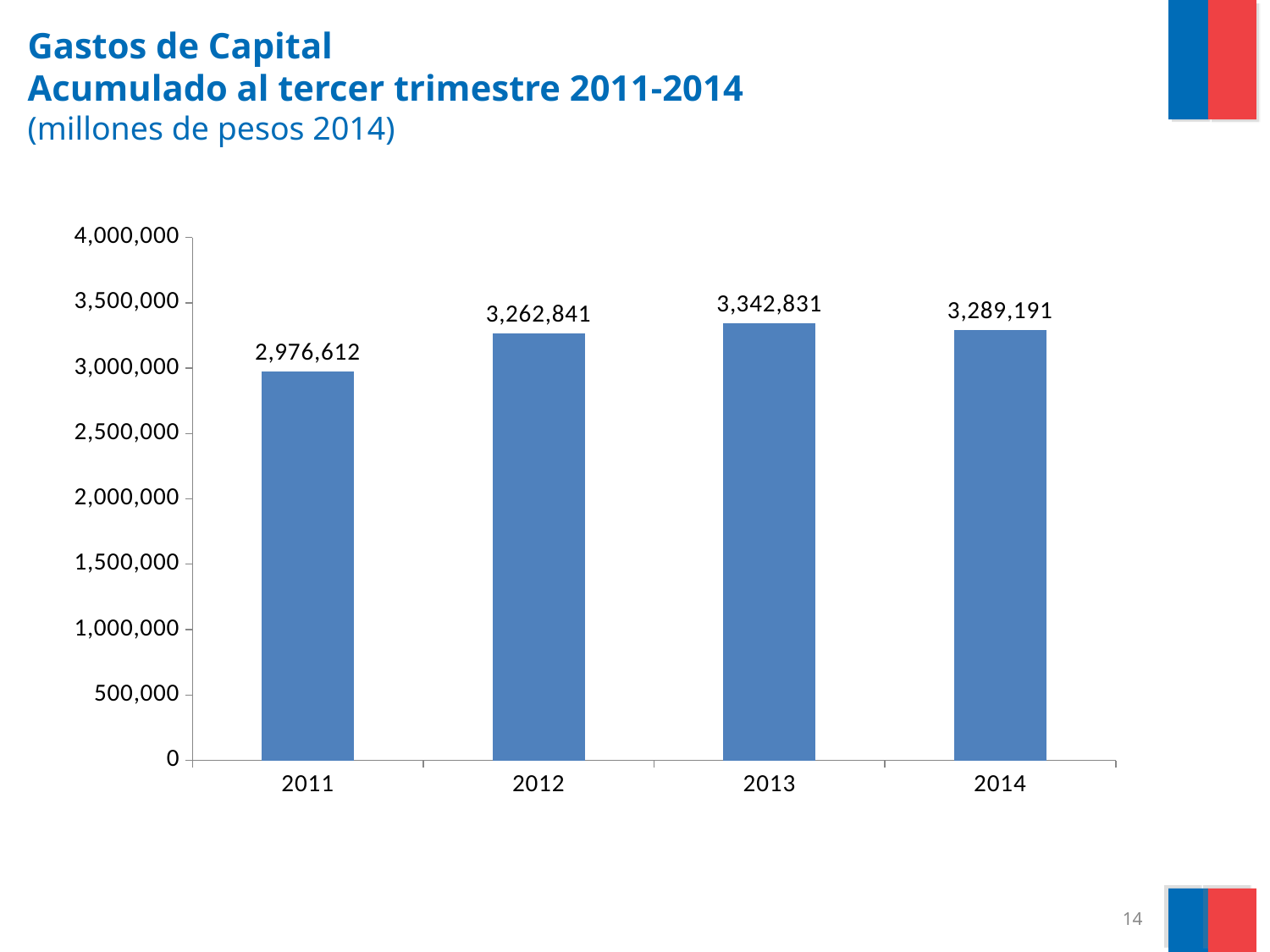
What is the value for 2011? 2,976,612 Which is larger, the value for 2012 or the value for 2014? 2014 Does the value rise or fall from 2013 to 2014? fall How many years are shown on the x axis? 4 What is the value for 2013? 3,342,831 What is the difference between the values for 2012 and 2011? 286,229 What is the difference between the values for 2013 and 2011? 366,219 Which year has the highest value? 2013 Is the value for 2011 greater or less than 3,000,000? less Which year has the lowest value? 2011 What is the value for 2014? 3,289,191 What kind of chart is shown on the slide? bar chart